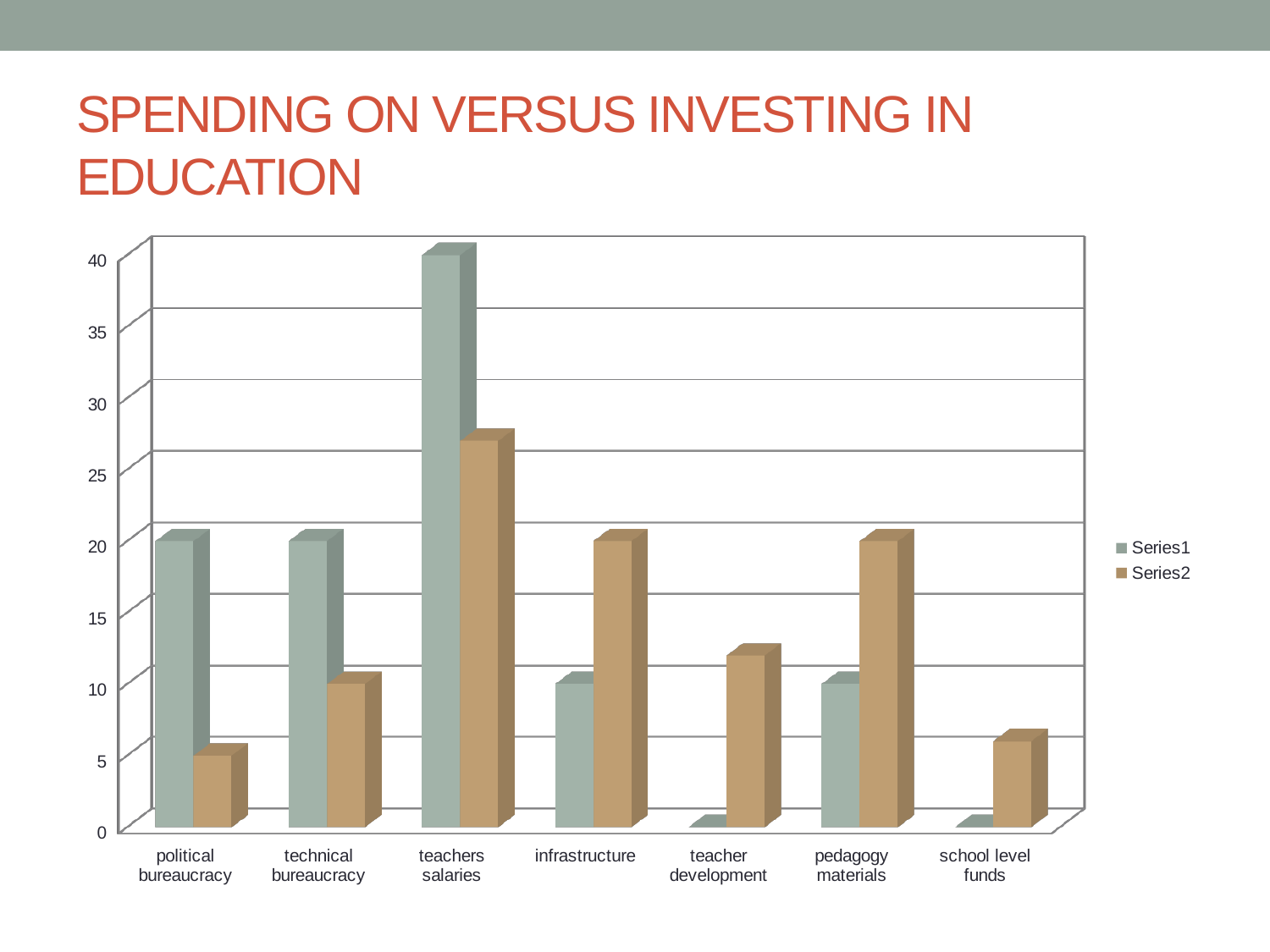
Which category has the highest Series1 value? teachers salaries How many series does the chart legend list? 2 What is the Series1 value for teachers salaries? 40 What is the Series2 value for infrastructure? 20 For infrastructure, which is larger: the Series1 value or the Series2 value? Series2 How many categories are shown on the x axis of the chart? 7 Which category has the highest Series2 value? teachers salaries What is the Series2 value for political bureaucracy? 5 Is the Series2 value for teachers salaries greater or less than 25? greater What is the difference between the Series1 values for teachers salaries and technical bureaucracy? 20 What type of chart is shown on the slide? bar chart What is the Series1 value for political bureaucracy? 20